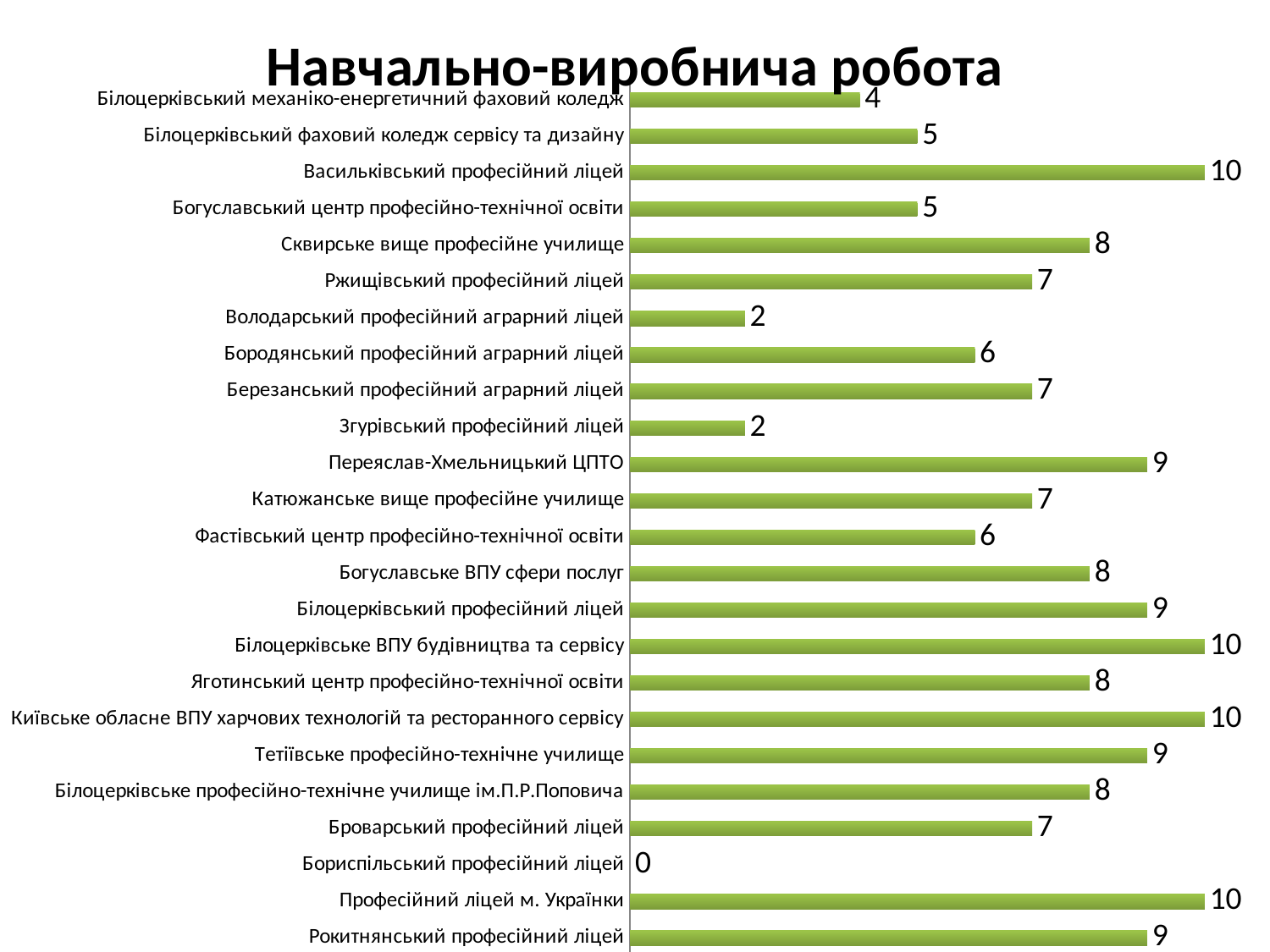
Which category has the lowest value? Бориспільський професійний ліцей What is the value for Володарський професійний аграрний ліцей? 2 How many categories are shown in the chart? 24 What is the title of the chart? Навчально-виробнича робота Which is larger, the value for Тетіївське професійно-технічне училище or the value for Броварський професійний ліцей? Тетіївське професійно-технічне училище What kind of chart is shown on the slide? Bar chart What is the value for Білоцерківський механіко-енергетичний фаховий коледж? 4 What is the value for Переяслав-Хмельницький ЦПТО? 9 What is the value for Васильківський професійний ліцей? 10 What is the difference between the values for Сквирське вище професійне училище and Згурівський професійний ліцей? 6 What is the value for Бориспільський професійний ліцей? 0 What is the difference between the values for Професійний ліцей м. Українки and Бородянський професійний аграрний ліцей? 4